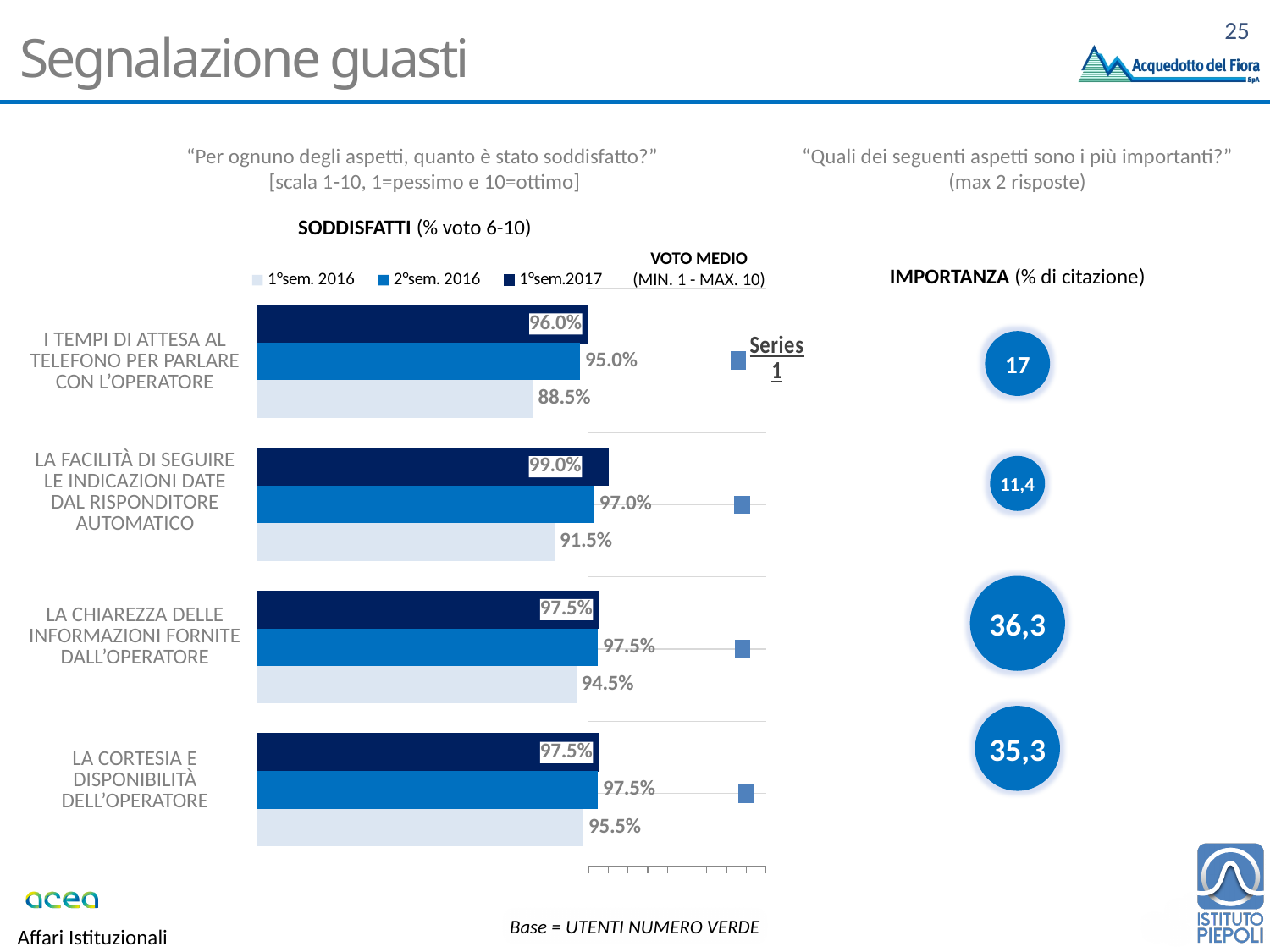
In the SODDISFATTI chart, what is the value for 1°sem. 2016 for 'I tempi di attesa al telefono per parlare con l'operatore'? 88.5% In the SODDISFATTI chart, which is larger for 'La facilità di seguire le indicazioni date dal risponditore automatico': the 2°sem. 2016 value or the 1°sem. 2016 value? 2°sem. 2016 In the SODDISFATTI chart, what is the value for 1°sem.2017 for 'La facilità di seguire le indicazioni date dal risponditore automatico'? 99.0% In the IMPORTANZA (% di citazione) chart, what is the value for 'La chiarezza delle informazioni fornite dall'operatore'? 36,3 In the SODDISFATTI chart, which category has the lowest 1°sem. 2016 value? I tempi di attesa al telefono per parlare con l'operatore In the SODDISFATTI chart, which category has the highest 1°sem.2017 value? La facilità di seguire le indicazioni date dal risponditore automatico How many series does the legend of the SODDISFATTI chart list? 3 How many categories are shown in the SODDISFATTI chart? 4 In the SODDISFATTI chart, what is the value for 2°sem. 2016 for 'La cortesia e disponibilità dell'operatore'? 97.5% In the IMPORTANZA (% di citazione) chart, which aspect has the lowest value? La facilità di seguire le indicazioni date dal risponditore automatico In the SODDISFATTI chart, what is the difference between the 1°sem.2017 and 1°sem. 2016 values for 'I tempi di attesa al telefono per parlare con l'operatore'? 7.5% What kind of chart is the SODDISFATTI chart? Bar chart